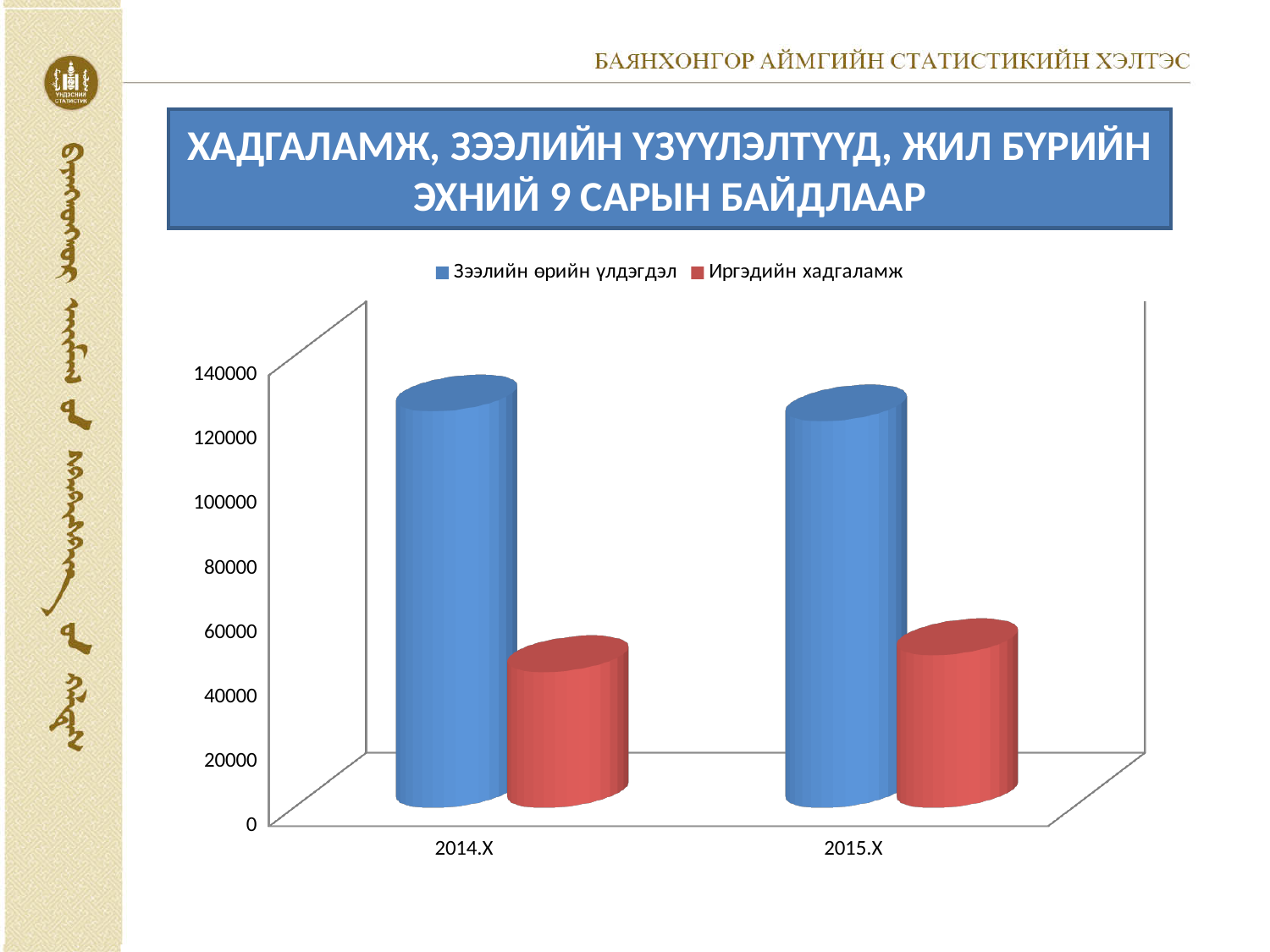
Is the value for Зээлийн өрийн үлдэгдэл in 2015.X greater or less than 100000? greater Is the value for Зээлийн өрийн үлдэгдэл in 2014.X greater or less than 100000? greater Is the value for Иргэдийн хадгаламж in 2014.X greater or less than 80000? less In 2014.X, which series has the lower value? Иргэдийн хадгаламж Which series is shown in blue? Зээлийн өрийн үлдэгдэл How many series does the legend list? 2 How many categories are shown on the x axis? 2 In 2015.X, which is larger: Зээлийн өрийн үлдэгдэл or Иргэдийн хадгаламж? Зээлийн өрийн үлдэгдэл What kind of chart is shown on the slide? bar chart Which series is shown in red? Иргэдийн хадгаламж